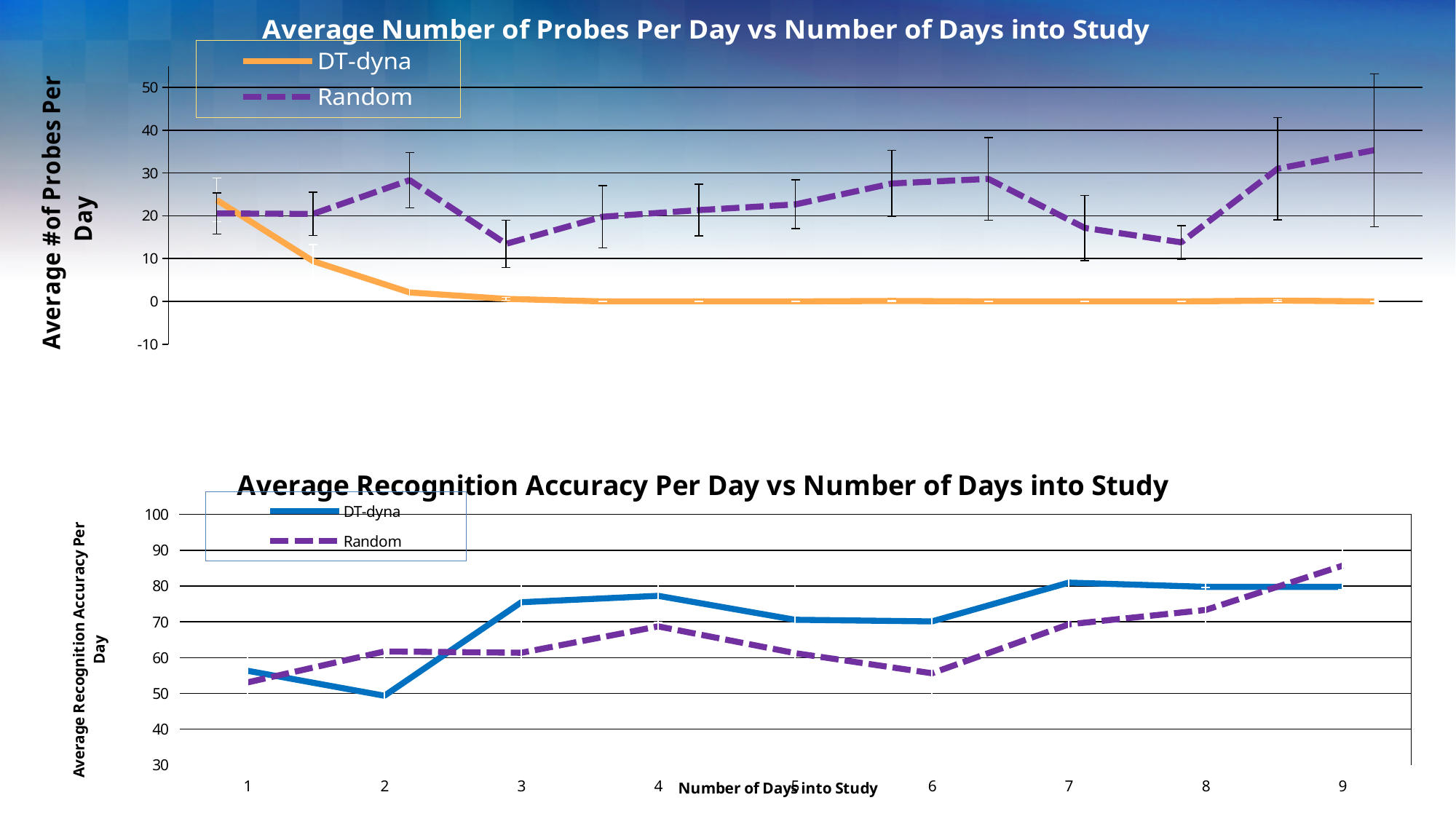
In the bottom chart, 'Average Recognition Accuracy Per Day vs Number of Days into Study', is the Random value at day 9 greater or less than 80? greater In the bottom chart, 'Average Recognition Accuracy Per Day vs Number of Days into Study', is the DT-dyna value at day 3 greater or less than 70? greater In the top chart, 'Average Number of Probes Per Day vs Number of Days into Study', which series is higher at the last point, DT-dyna or Random? Random In the bottom chart, 'Average Recognition Accuracy Per Day vs Number of Days into Study', which series is higher at day 9, DT-dyna or Random? Random In the bottom chart, 'Average Recognition Accuracy Per Day vs Number of Days into Study', on which day is the DT-dyna series lowest? 2 In the top chart, 'Average Number of Probes Per Day vs Number of Days into Study', does the DT-dyna series rise or fall along the x axis? fall What kind of chart is the top chart, 'Average Number of Probes Per Day vs Number of Days into Study'? line chart In the bottom chart, 'Average Recognition Accuracy Per Day vs Number of Days into Study', which series is higher at day 3, DT-dyna or Random? DT-dyna How many series does the legend of the bottom chart, 'Average Recognition Accuracy Per Day vs Number of Days into Study', list? 2 In the top chart, 'Average Number of Probes Per Day vs Number of Days into Study', is the last value of the Random series greater or less than 30? greater In the bottom chart, 'Average Recognition Accuracy Per Day vs Number of Days into Study', on which day is the Random series highest? 9 In the bottom chart, 'Average Recognition Accuracy Per Day vs Number of Days into Study', how many days are shown on the x axis? 9